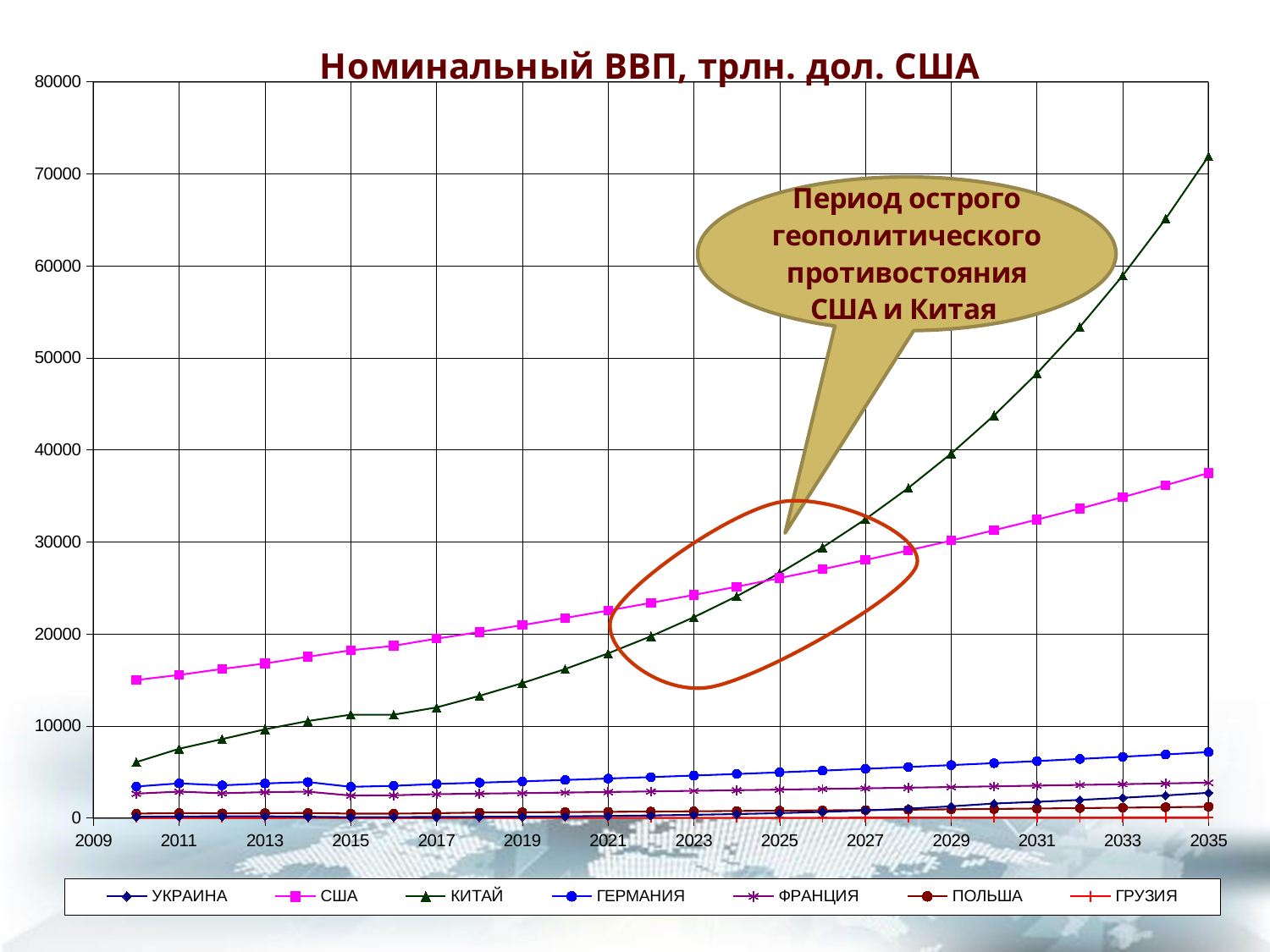
Which series has the highest value in 2035? КИТАЙ Is the value for США in 2010 greater or less than 10000? greater Is the value for КИТАЙ in 2035 greater or less than 70000? greater Is the value for КИТАЙ in 2010 greater or less than 10000? less Which series has the lowest value in 2035? ГРУЗИЯ What is the title of the chart? Номинальный ВВП, трлн. дол. США In 2035, which is larger: the value for КИТАЙ or the value for США? КИТАЙ In 2010, which is larger: the value for США or the value for КИТАЙ? США What kind of chart is shown on the slide? line chart How many series does the legend list? 7 Does the value for КИТАЙ rise or fall from 2010 to 2035? rise